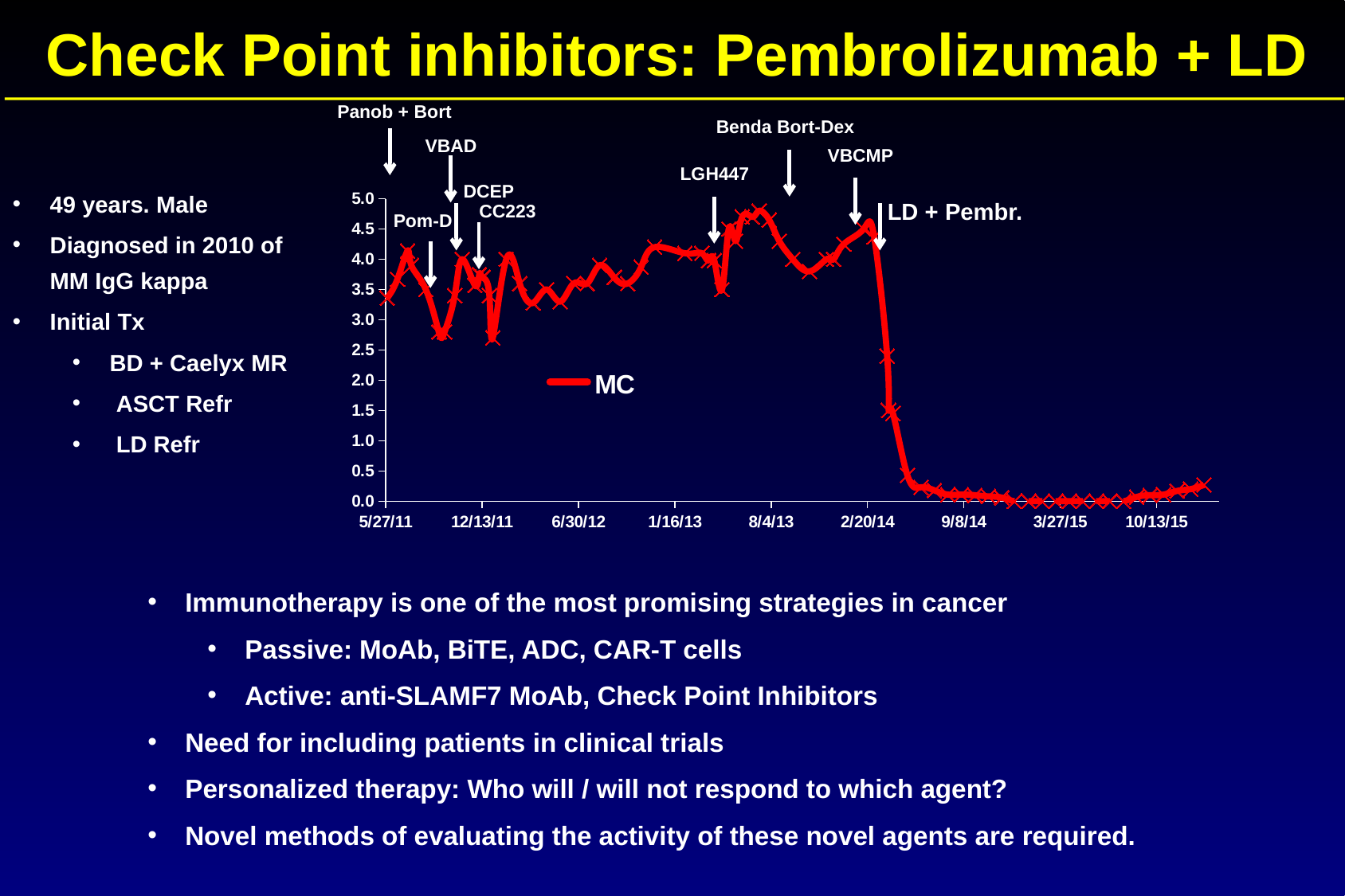
What is the first date label on the x axis of the chart? 5/27/11 Is the MC value at 10/13/15 greater or less than 1.0? less What is the highest value shown on the y axis of the chart? 5.0 Do the MC values rise or fall after the point marked LD + Pembr.? fall What is the name of the series shown in the chart legend? MC What kind of chart is shown on the slide? line chart Is the MC value at 9/8/14 greater or less than 0.5? less Is the MC value at 8/4/13 greater or less than 4.0? greater How many date labels are shown on the x axis of the chart? 9 How many series does the chart legend list? 1 Which is larger, the MC value at 2/20/14 or the MC value at 9/8/14? 2/20/14